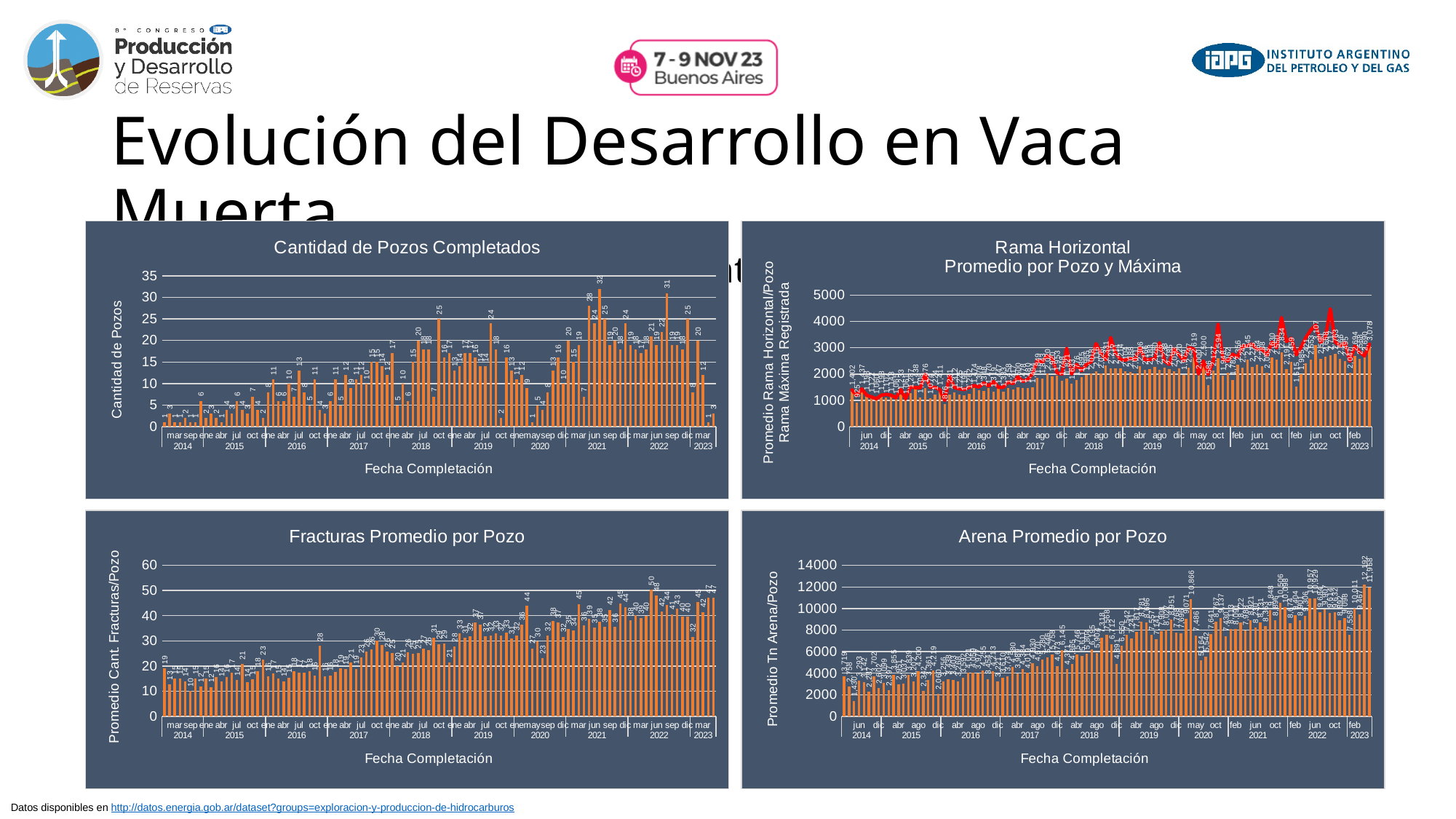
In the 'Fracturas Promedio por Pozo' chart, what is the highest value shown by any bar? 50 In the 'Fracturas Promedio por Pozo' chart, is the value for mar 2014 greater or less than 30? less In the 'Arena Promedio por Pozo' chart, is the value for jun 2014 greater or less than 6000? less What kind of chart is 'Cantidad de Pozos Completados'? bar chart In the 'Rama Horizontal Promedio por Pozo y Máxima' chart, what is the highest value labelled on the vertical axis? 5000 In the 'Rama Horizontal Promedio por Pozo y Máxima' chart, do the values generally rise or fall from 2014 to 2023? rise In the 'Cantidad de Pozos Completados' chart, is the value for mar 2014 greater or less than 10? less In the 'Fracturas Promedio por Pozo' chart, do the values generally rise or fall from 2014 to 2023? rise What is the vertical axis title of the 'Arena Promedio por Pozo' chart? Promedio Tn Arena/Pozo In the 'Arena Promedio por Pozo' chart, do the values generally rise or fall from 2014 to 2023? rise In the 'Cantidad de Pozos Completados' chart, what is the highest value shown by any bar? 32